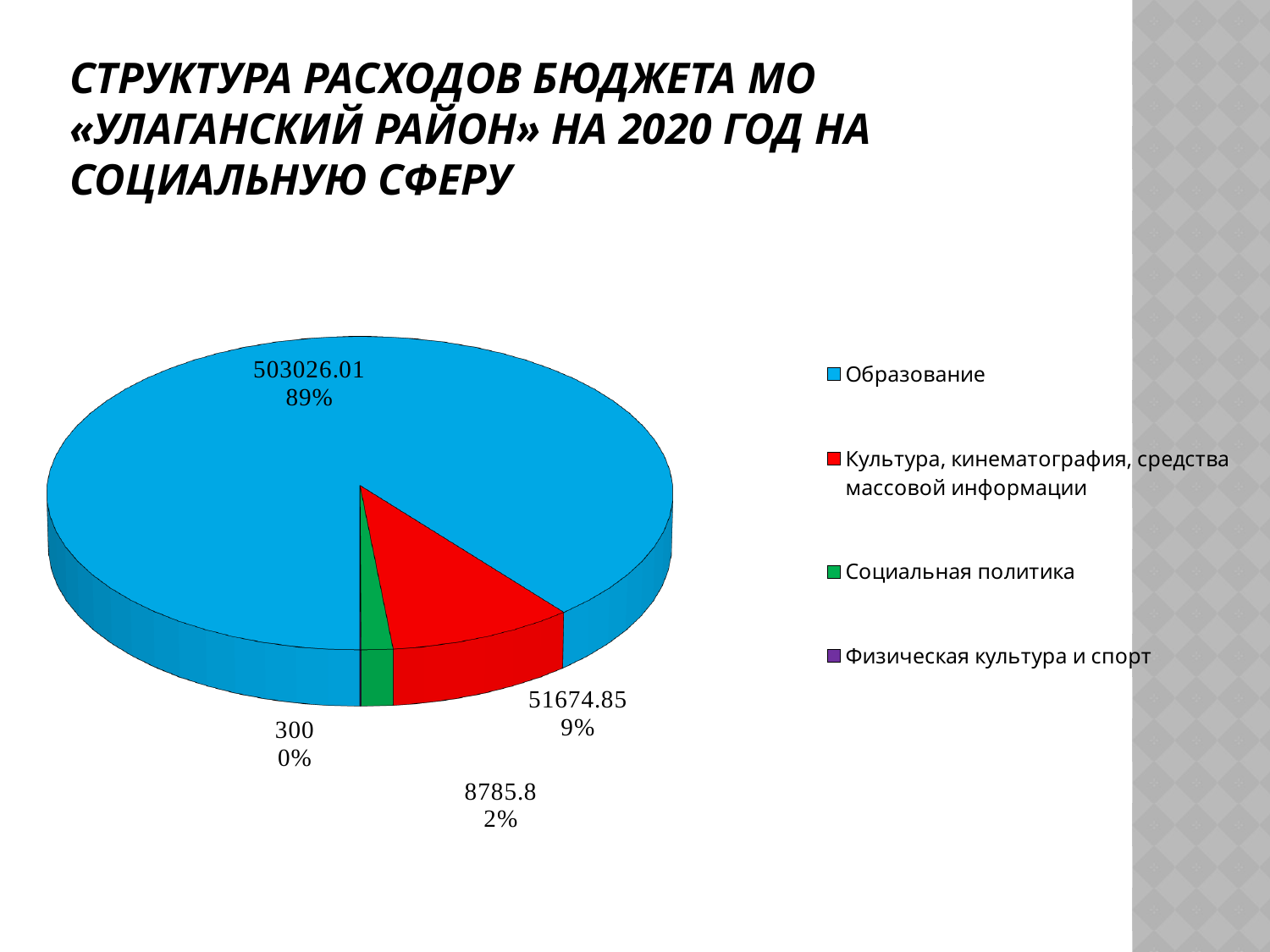
What is the value shown for Культура, кинематография, средства массовой информации? 51674.85 What type of chart is shown on the slide? Pie chart Which category has the largest slice of the pie? Образование What is the value shown for Образование? 503026.01 What is the value shown for Социальная политика? 8785.8 What share of the pie does Культура, кинематография, средства массовой информации represent? 9% What is the value shown for Физическая культура и спорт? 300 How many categories does the legend of the pie chart list? 4 What is the difference between the values for Образование and Культура, кинематография, средства массовой информации? 451351.16 Which category has the smallest slice of the pie? Физическая культура и спорт What share of the pie does Образование represent? 89% What share of the pie does Социальная политика represent? 2%